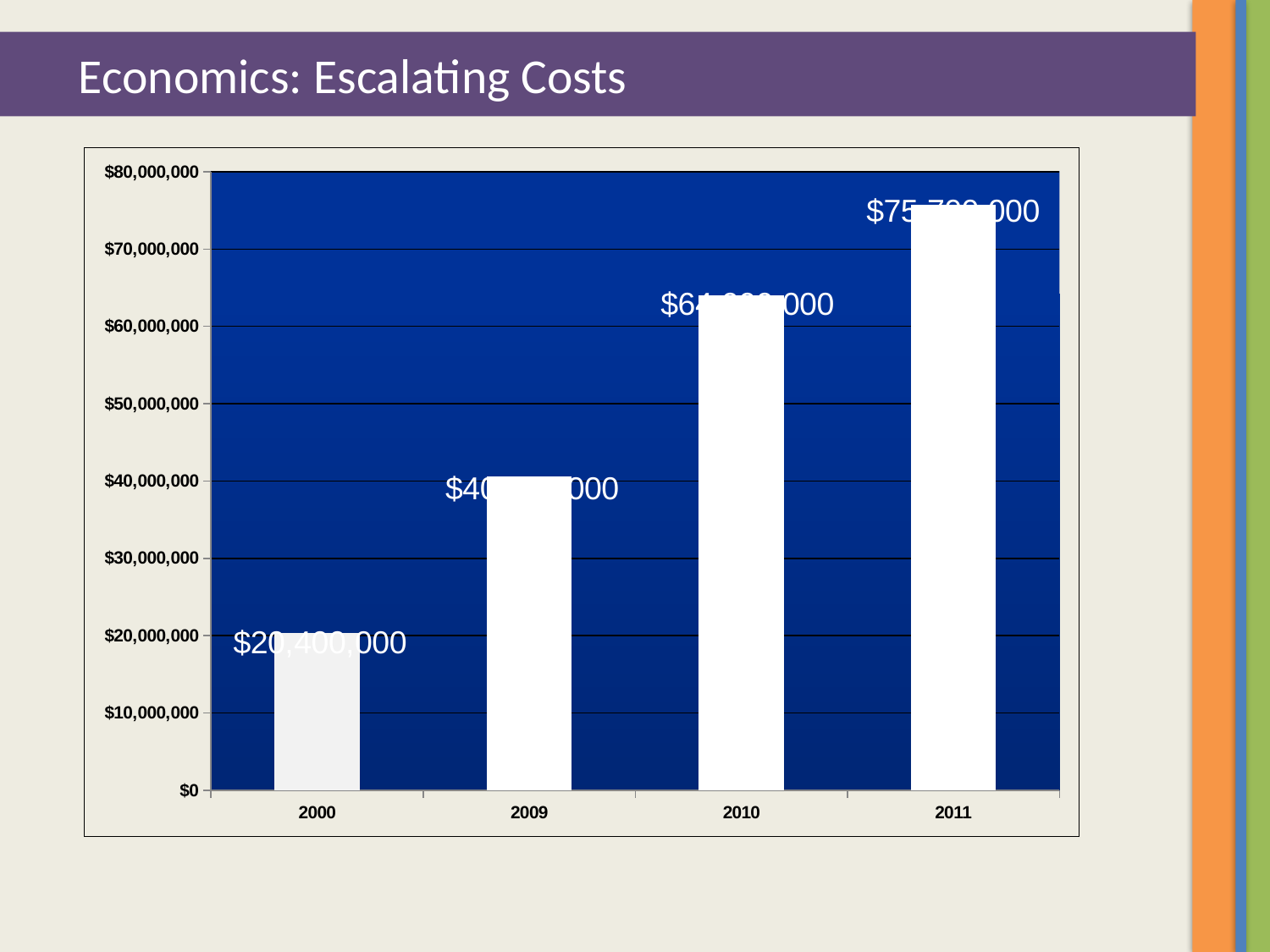
Which year has the highest value? 2011 What is the title of the slide containing the chart? Economics: Escalating Costs Is the value for 2009 greater or less than $50,000,000? less What is the value for 2000? $20,400,000 Do the values rise or fall from 2000 to 2011? rise Is the value for 2011 greater or less than $70,000,000? greater What kind of chart is shown on the slide? bar chart Which year has the lowest value? 2000 Which is larger, the value for 2009 or the value for 2010? 2010 Is the value for 2010 greater or less than $60,000,000? greater How many years are shown on the x axis? 4